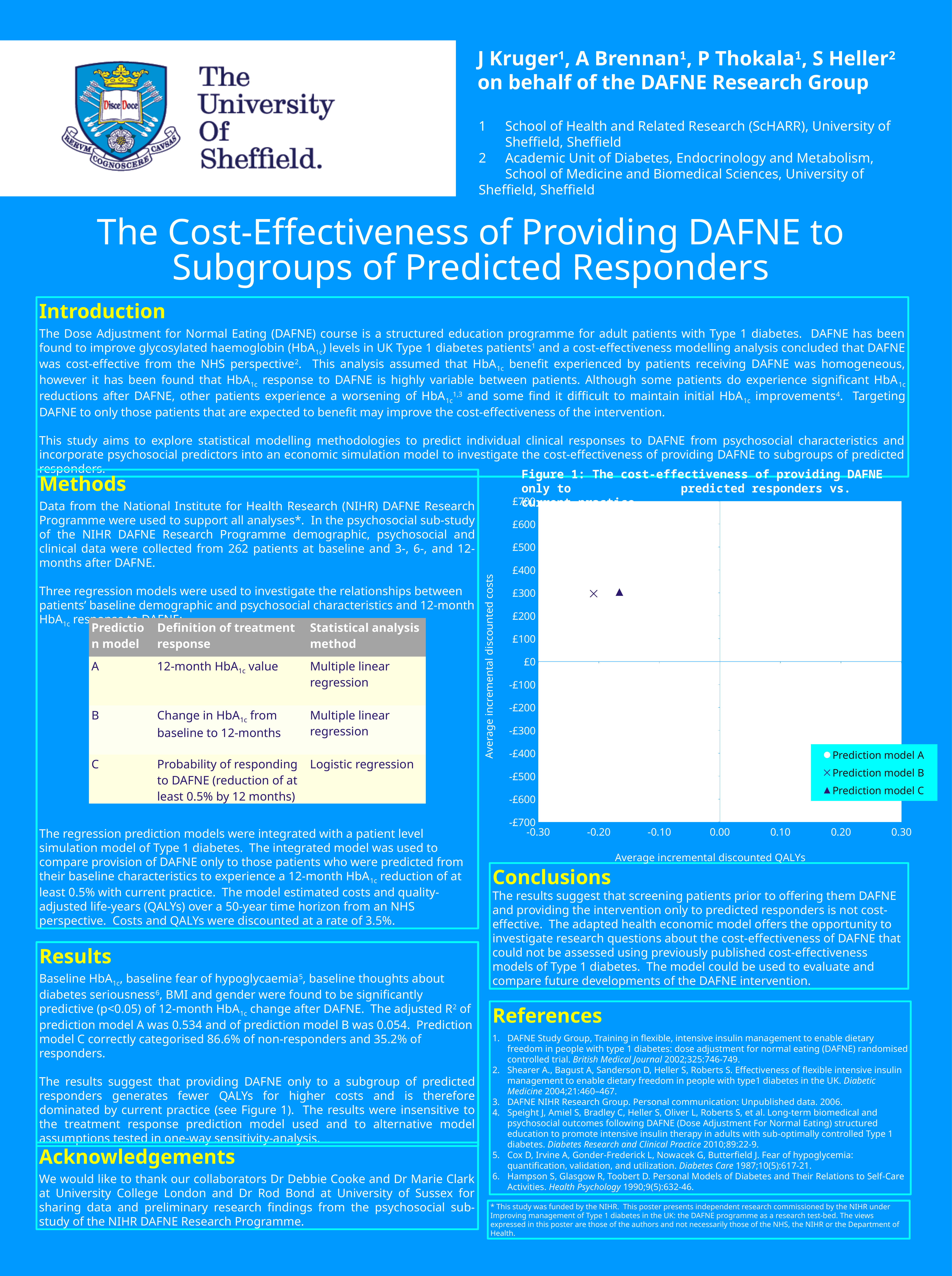
In Figure 1, is the average incremental discounted cost for Prediction model C greater or less than £400? less What is the label of the vertical axis in Figure 1? Average incremental discounted costs In Figure 1, which has the larger average incremental discounted QALYs, Prediction model B or Prediction model C? Prediction model C In Figure 1, are the average incremental discounted QALYs for Prediction model C greater or less than 0.00? less In Figure 1, are the average incremental discounted QALYs for Prediction model B greater or less than -0.10? less What is the label of the horizontal axis in Figure 1? Average incremental discounted QALYs What kind of chart is Figure 1? scatter chart How many series does the legend of Figure 1 list? 3